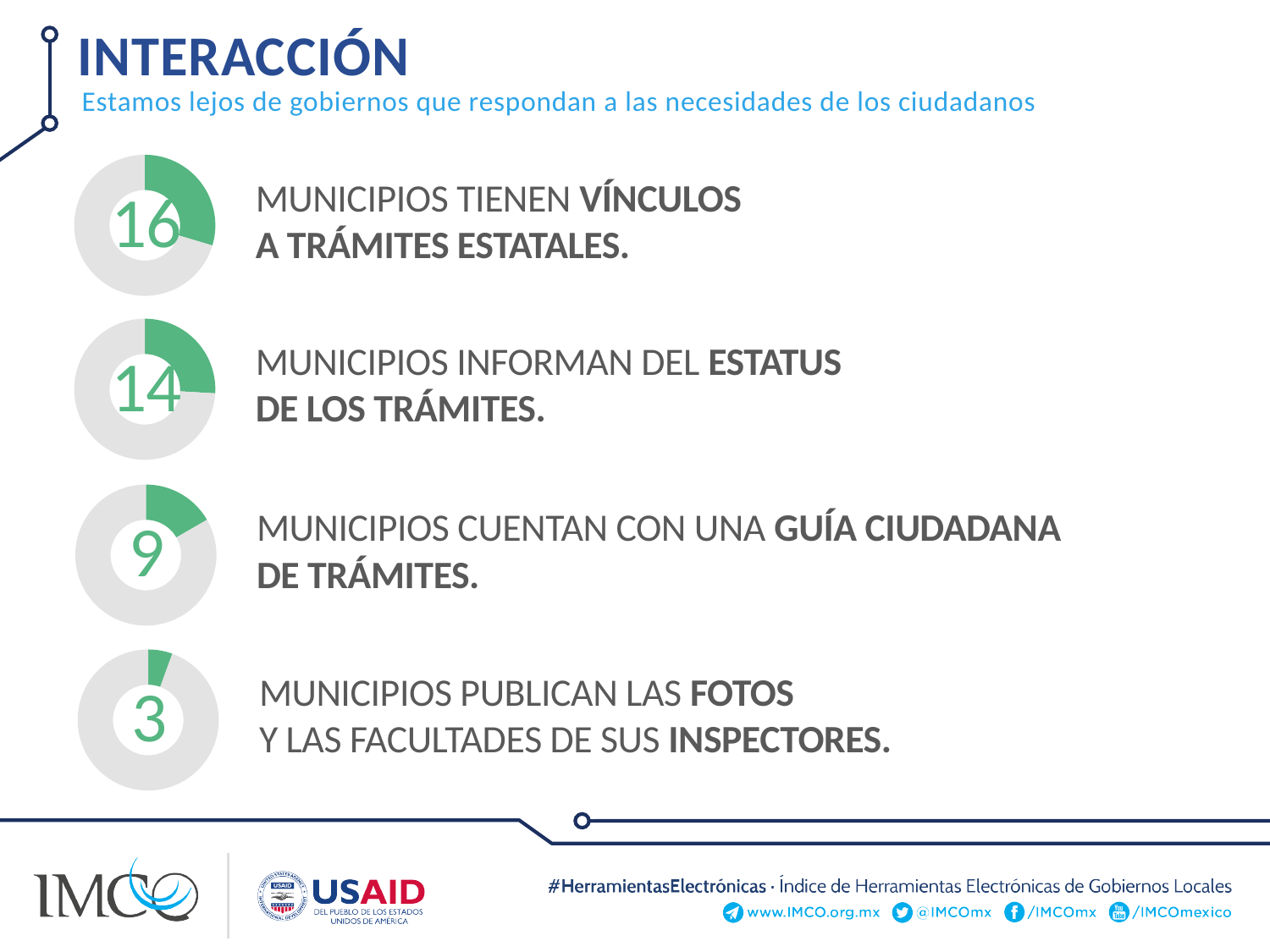
How many municipalities have links to state procedures (vínculos a trámites estatales), according to the first donut chart? 16 How many municipalities have a citizen guide to procedures (guía ciudadana de trámites), according to the third donut chart? 9 What kind of chart is used to show each indicator on the slide? Donut chart How many donut charts are shown on the slide? 4 What colour is used for the filled portion of each donut chart? Green What is the difference between the number of municipalities with links to state procedures and the number that publish photos of their inspectors? 13 Which is larger: the number of municipalities with links to state procedures or the number that report the status of procedures? Links to state procedures (16) Which of the four indicators on the slide has the highest number of municipalities? Vínculos a trámites estatales What is the difference between the number of municipalities that report the status of procedures and the number with a citizen guide to procedures? 5 How many municipalities report the status of procedures (estatus de los trámites), according to the second donut chart? 14 Which of the four indicators on the slide has the lowest number of municipalities? Fotos y facultades de sus inspectores How many municipalities publish the photos and powers of their inspectors, according to the fourth donut chart? 3